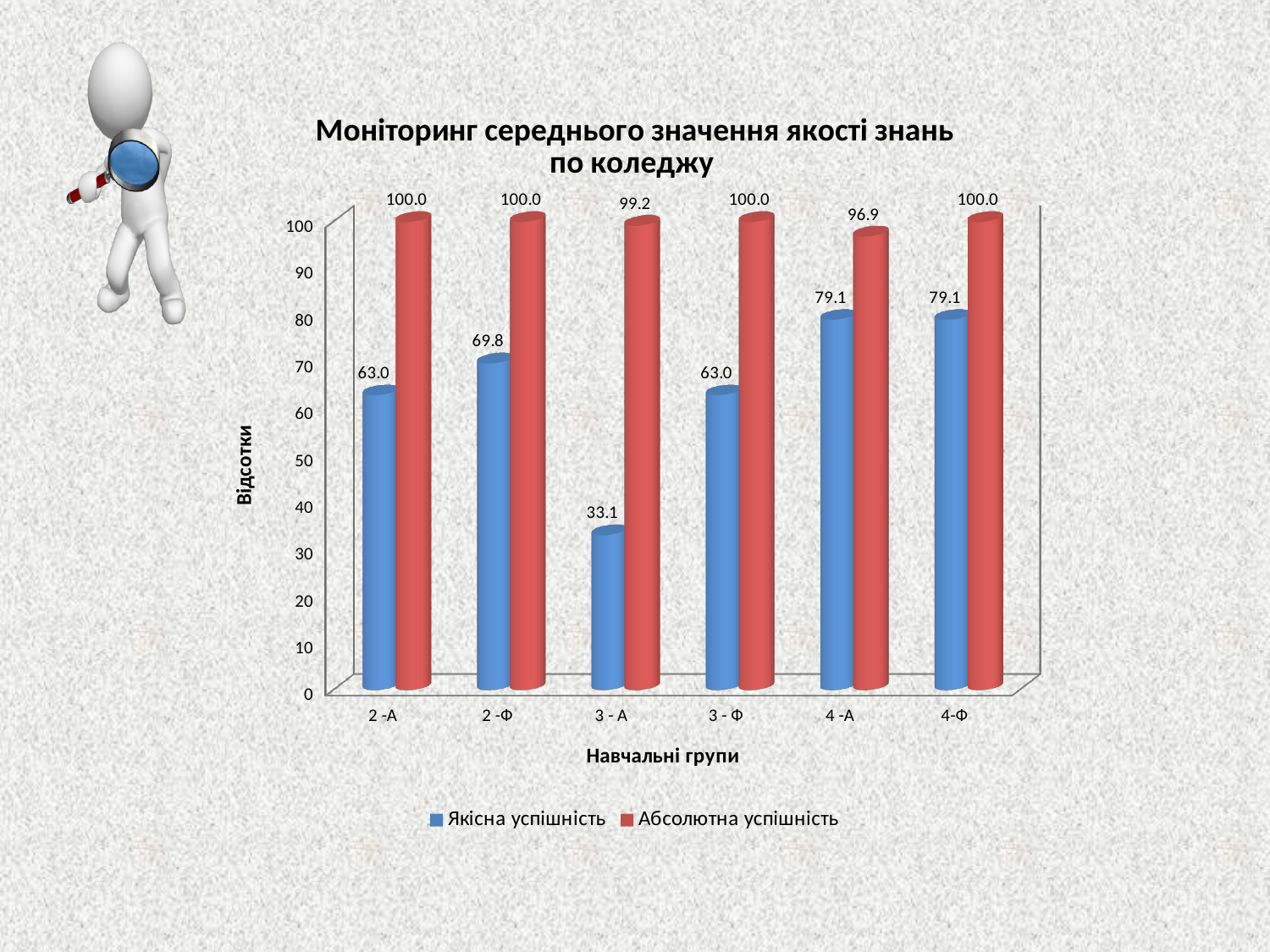
What is the value of Якісна успішність for group 2 -Ф? 69.8 Which is larger: Якісна успішність for group 2 -Ф or for group 3 - Ф? 2 -Ф How many series does the legend list? 2 Which group has the lowest Абсолютна успішність? 4 -А How many groups are shown on the x axis? 6 What is the difference in Якісна успішність between group 4 -А and group 2 -А? 16.1 What is the value of Абсолютна успішність for group 4 -А? 96.9 Which group has the lowest Якісна успішність? 3 - А What is the label of the y axis? Відсотки What is the difference between Абсолютна успішність and Якісна успішність for group 3 - А? 66.1 What is the value of Якісна успішність for group 3 - А? 33.1 What kind of chart is shown on the slide? Bar chart